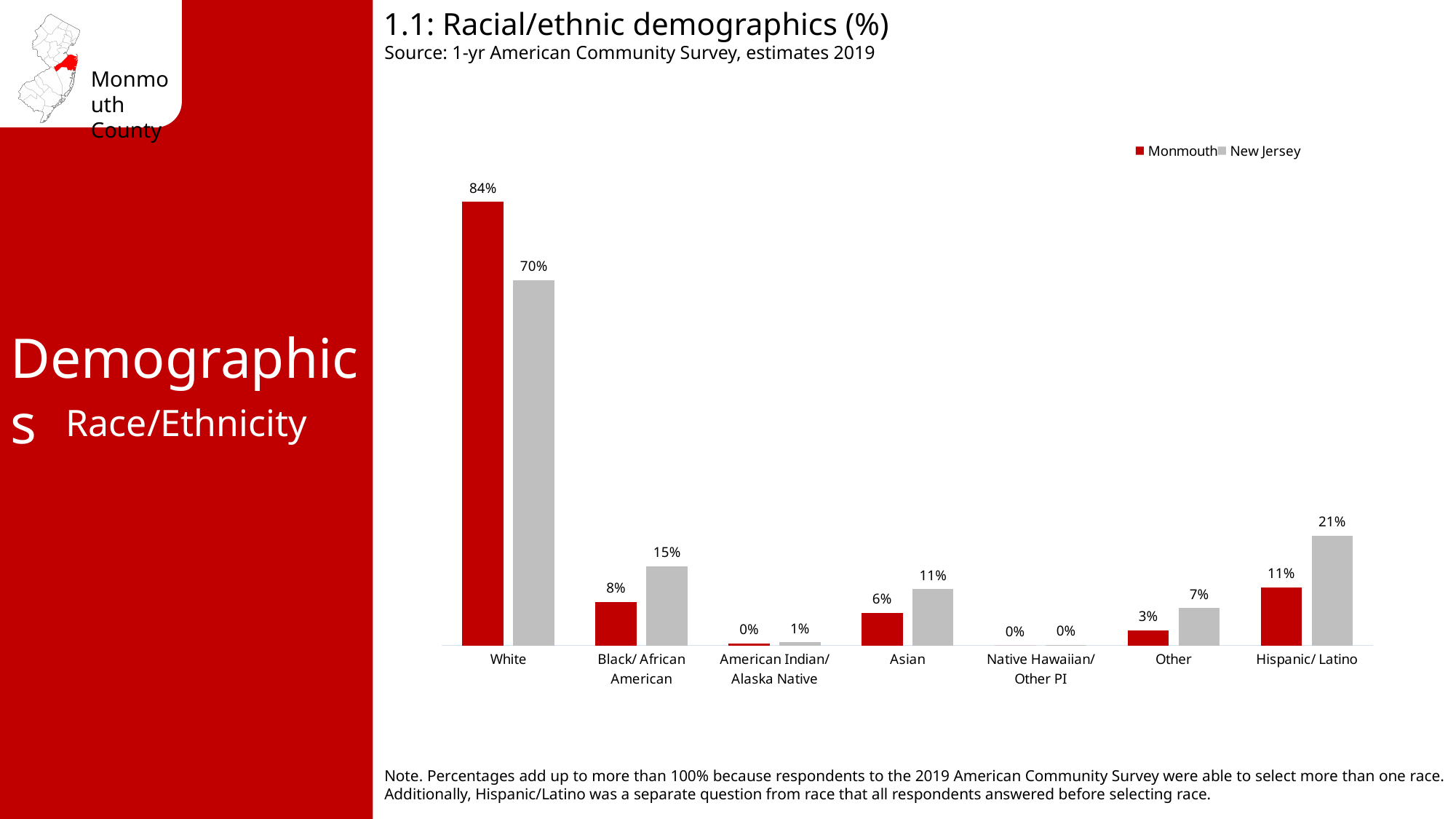
What is the Monmouth value for Asian? 6% What is the difference between the Monmouth and New Jersey values for White? 14% What is the difference between the New Jersey and Monmouth values for Hispanic/ Latino? 10% How many series does the legend list? 2 What is the Monmouth value for White? 84% How many categories are shown on the x axis? 7 What is the New Jersey value for Hispanic/ Latino? 21% Which category has the lowest New Jersey value? Native Hawaiian/ Other PI What is the New Jersey value for Black/ African American? 15% Which category has the highest Monmouth value? White What kind of chart is shown on the slide? Bar chart Which is larger for Other: the Monmouth value or the New Jersey value? New Jersey